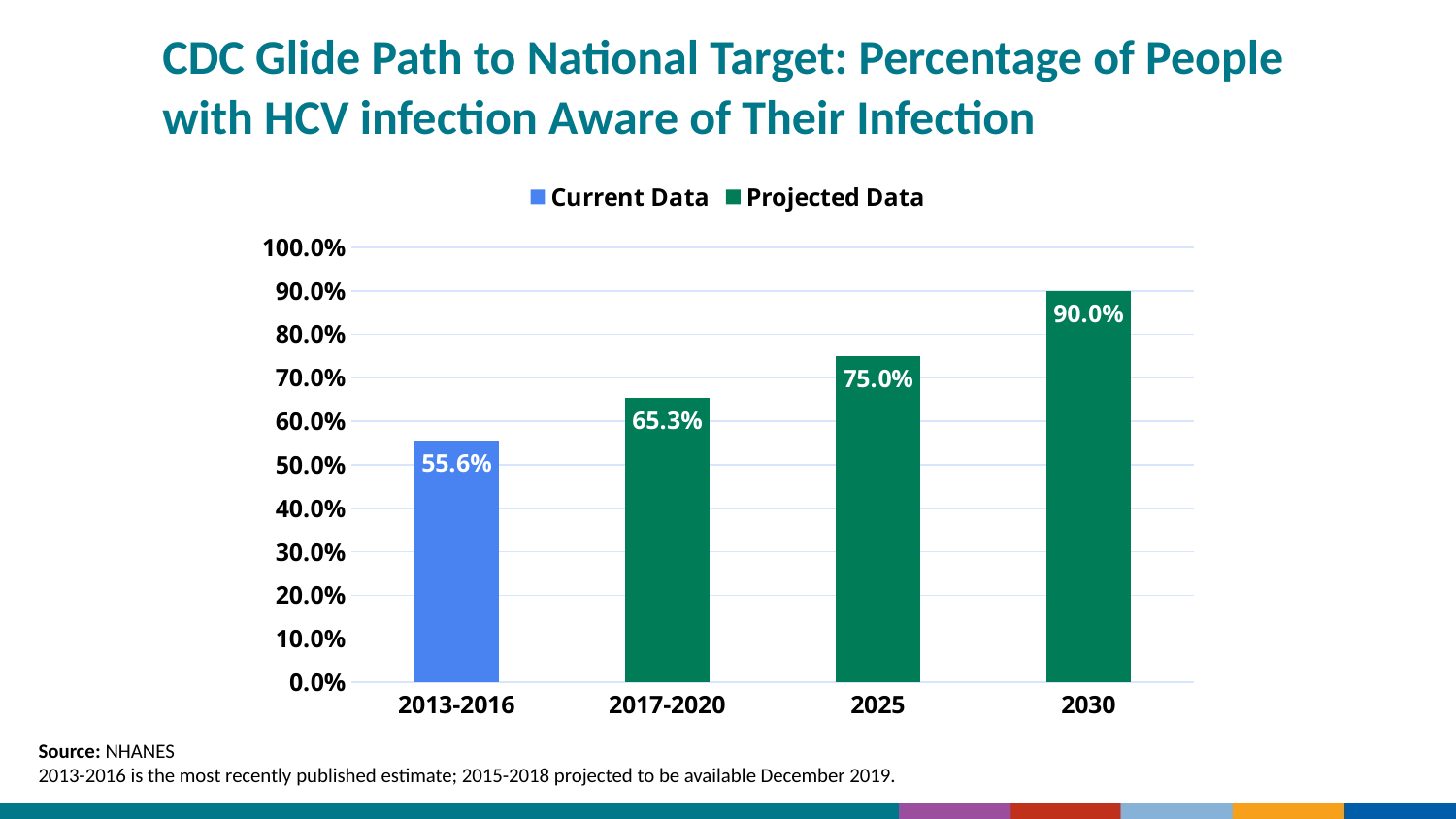
How many series does the legend list? 2 Which category has the lowest value? 2013-2016 Is the value for 2013-2016 greater or less than 60.0%? less What kind of chart is shown? bar chart What is the value for 2025? 75.0% Which is larger, the value for 2017-2020 or the value for 2025? 2025 What is the difference between the values for 2030 and 2013-2016? 34.4% What is the value for 2030? 90.0% Which category has the highest value? 2030 How many categories are shown on the x axis? 4 What is the value for 2013-2016? 55.6% What is the value for 2017-2020? 65.3%